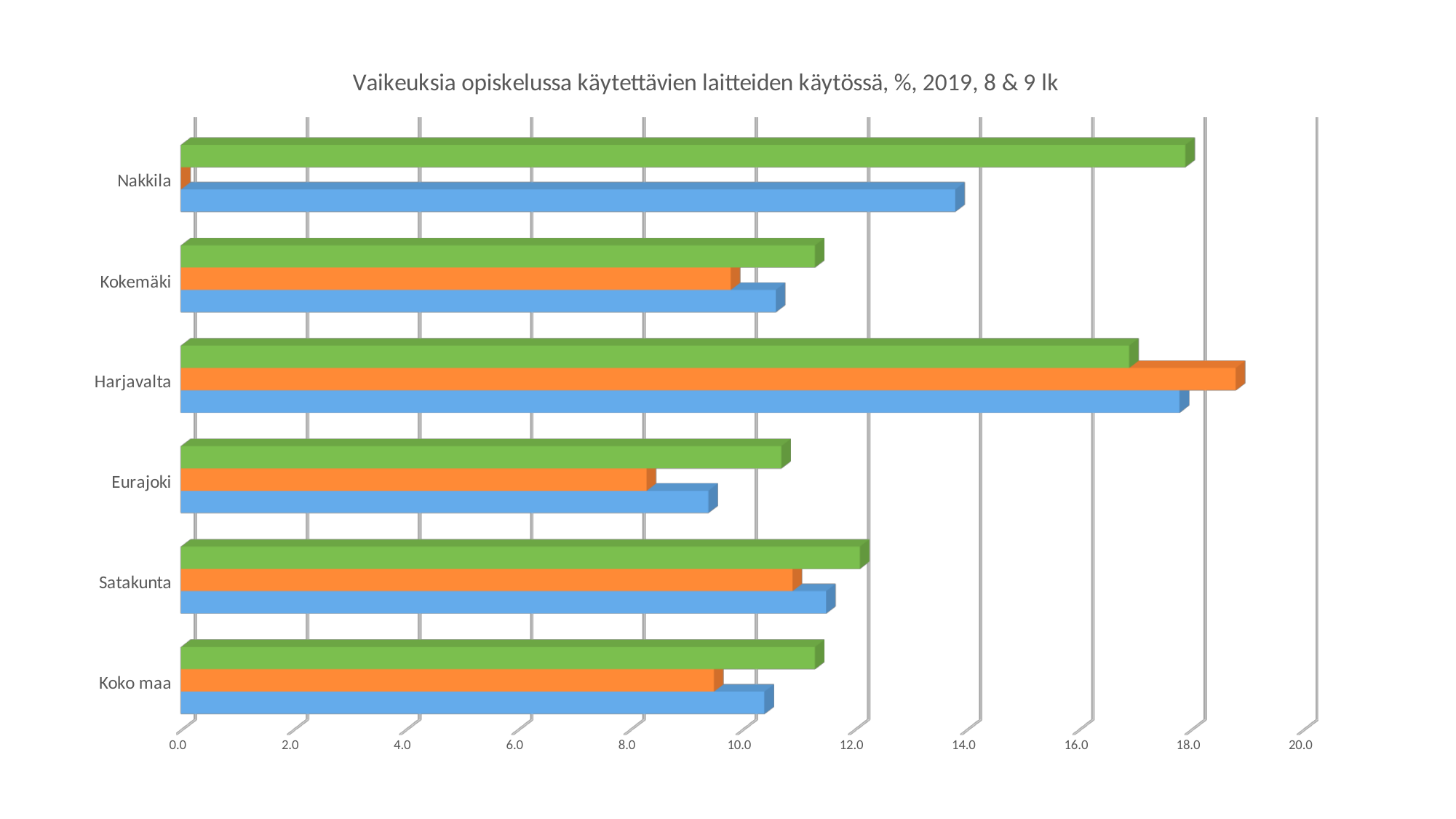
How many bars are plotted for each category? 3 For Nakkila, is the green bar or the blue bar larger? green For Harjavalta, is the orange bar or the green bar larger? orange Which category has the shortest orange bar? Nakkila Which category has the longest green bar? Nakkila Which category has the shortest blue bar? Eurajoki Which category has the longest orange bar? Harjavalta Is the value of the orange bar for Eurajoki greater or less than 10.0? less How many categories (municipalities/regions) are shown on the chart? 6 What kind of chart is shown on the slide? bar chart What is the title of the chart? Vaikeuksia opiskelussa käytettävien laitteiden käytössä, %, 2019, 8 & 9 lk Is the value of the orange bar for Harjavalta greater or less than 18.0? greater